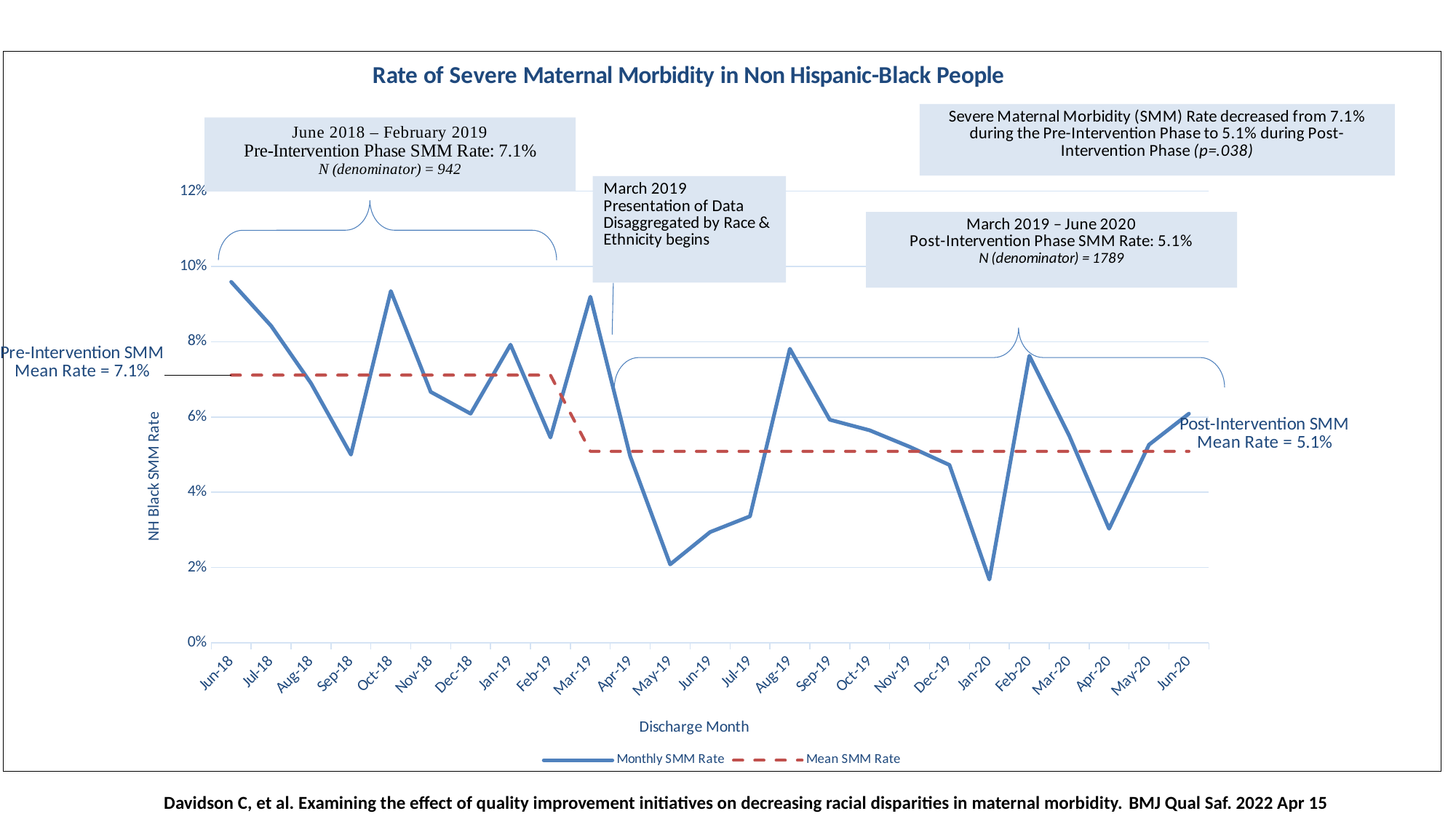
Which is larger, the Monthly SMM Rate for Jun-18 or for Sep-18? Jun-18 Is the Monthly SMM Rate for Jun-18 greater or less than 8%? greater What is the Post-Intervention SMM mean rate shown on the chart? 5.1% What is the title of the chart? Rate of Severe Maternal Morbidity in Non Hispanic-Black People Is the Monthly SMM Rate for May-19 greater or less than 4%? less Is the Monthly SMM Rate for Jan-20 greater or less than 2%? less Does the Mean SMM Rate line rise or fall when moving from the Pre-Intervention phase to the Post-Intervention phase? Fall How many discharge months are plotted along the x axis? 25 What is the Pre-Intervention SMM mean rate shown on the chart? 7.1% How many series does the legend list? 2 What kind of chart is shown on the slide? Line chart By how many percentage points did the mean SMM rate decrease from the Pre-Intervention phase to the Post-Intervention phase? 2.0 percentage points